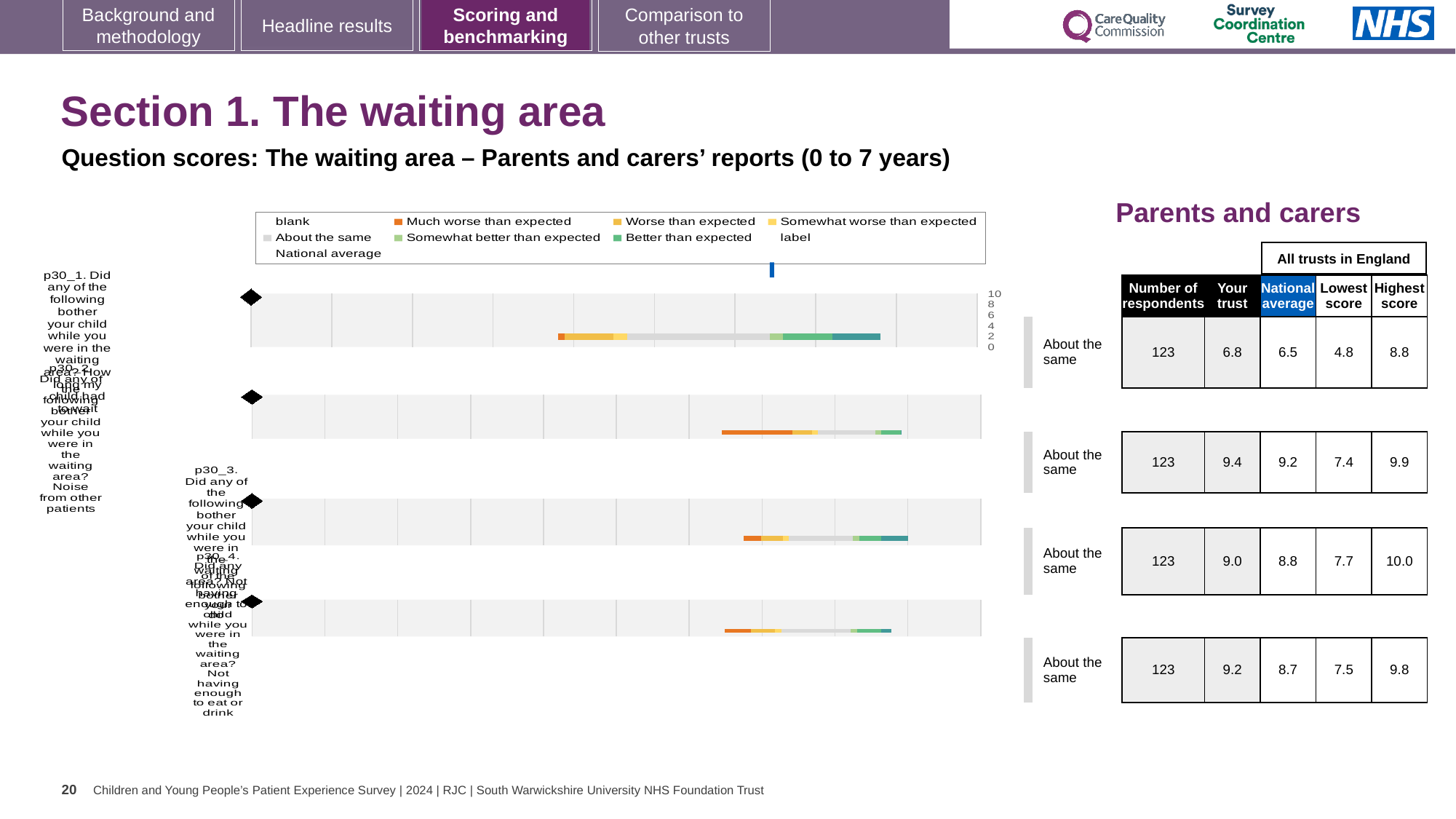
How many entries does the chart legend list? 9 How many question charts (rows) are shown on the slide? 4 What colour represents 'Much worse than expected' in the chart legend? orange In the table beside the charts, what is the national average for the second question (p30_2)? 9.2 What benchmark label is shown next to each of the four question charts? About the same What kind of chart is used to show the question scores on this slide? bar chart Which question has the highest 'Your trust' score in the table beside the charts? p30_2 In the table beside the charts, how many respondents are listed for the fourth question (p30_4)? 123 In the table beside the charts, what is the highest score in England for the third question (p30_3)? 10.0 In the table beside the charts, what is the 'Your trust' score for the first question (p30_1)? 6.8 For the fourth question (p30_4), what is the difference between the 'Your trust' score and the national average in the table? 0.5 Which question has the lowest 'Your trust' score in the table beside the charts? p30_1